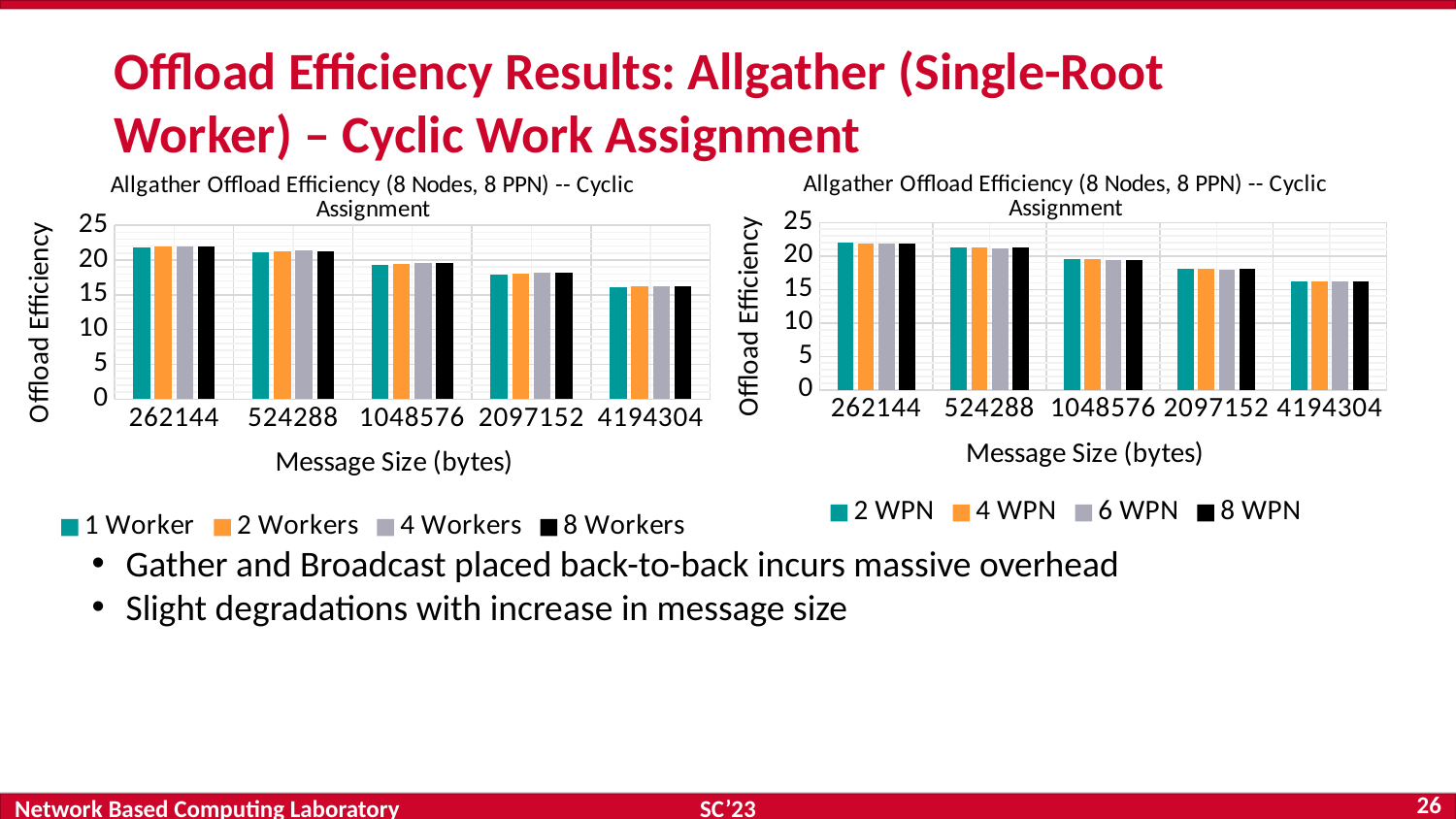
How many series does the legend of the right chart list? 4 In the left chart, is the offload efficiency for 8 Workers at message size 4194304 greater or less than 20? less In the right chart, is the offload efficiency for 8 WPN at message size 1048576 greater or less than 20? less How many series does the legend of the left chart list? 4 How many message sizes are shown on the x axis of the left chart? 5 In the left chart, is the offload efficiency for 1 Worker at message size 262144 greater or less than 20? greater In the right chart, do the offload efficiency values rise or fall as message size increases along the x axis? fall What kind of chart is the left chart on the slide? bar chart What is the x-axis label of the left chart? Message Size (bytes) In the right chart, which message size has the lowest offload efficiency? 4194304 In the left chart, which message size has the highest offload efficiency? 262144